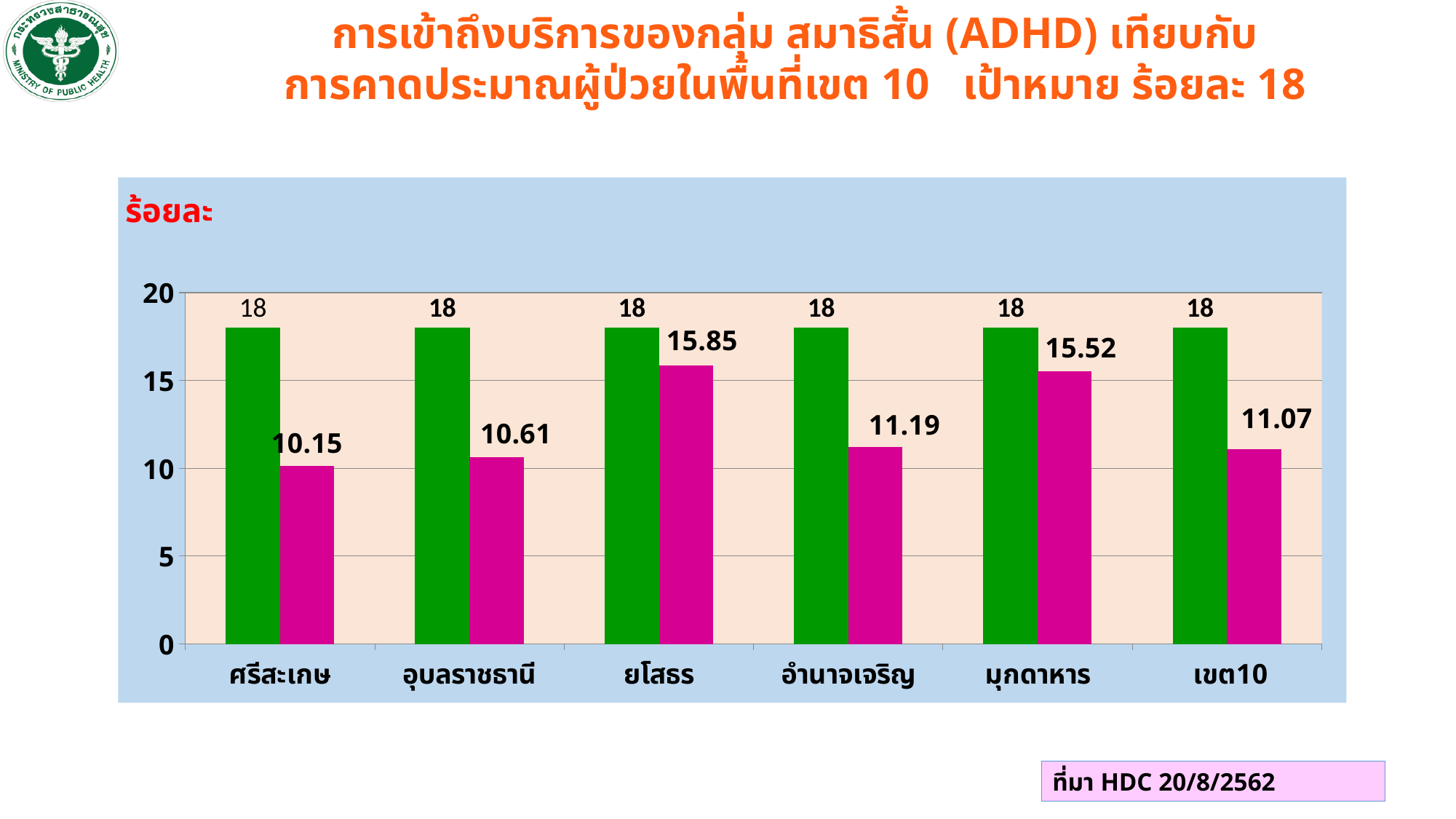
What is the value of the green bar for มุกดาหาร? 18 What kind of chart is shown on the slide? bar chart What is the difference between the green bar and the magenta bar for อำนาจเจริญ? 6.81 Which category has the highest magenta bar? ยโสธร Which is larger, the magenta bar for อุบลราชธานี or the magenta bar for มุกดาหาร? มุกดาหาร What is the value of the magenta bar for ศรีสะเกษ? 10.15 What is the value of the magenta bar for เขต10? 11.07 How many categories are shown on the x axis? 6 What is the label shown at the top left of the chart area? ร้อยละ Which category has the lowest magenta bar? ศรีสะเกษ Is the magenta bar for ยโสธร greater or less than 15? greater What is the value of the magenta bar for ยโสธร? 15.85